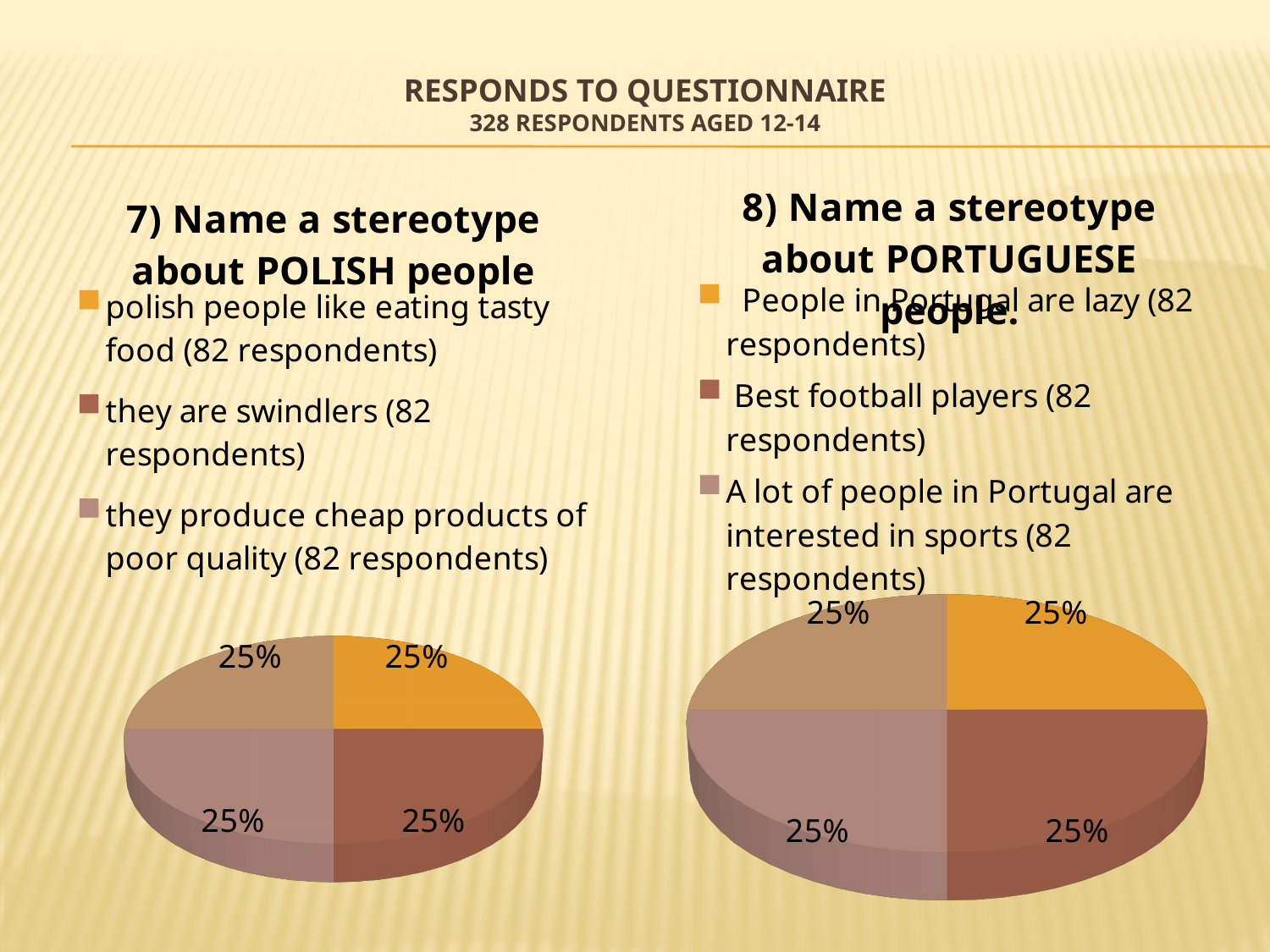
What is the title of the right pie chart? 8) Name a stereotype about PORTUGUESE people. In the right pie chart (PORTUGUESE people), which is larger: the slice for 'People in Portugal are lazy' or the slice for 'A lot of people in Portugal are interested in sports'? they are equal In the left pie chart (POLISH people), what share of the pie does the slice for 'they are swindlers' represent? 25% In the left pie chart (POLISH people), which is larger: the slice for 'they are swindlers' or the slice for 'they produce cheap products of poor quality'? they are equal In the right pie chart (PORTUGUESE people), what share of the pie does the slice for 'Best football players' represent? 25% In the right pie chart (PORTUGUESE people), what share of the pie does the slice for 'People in Portugal are lazy' represent? 25% In the left pie chart (POLISH people), how many slices does the pie have? 4 What kind of chart is shown under the heading '8) Name a stereotype about PORTUGUESE people'? pie chart In the right pie chart (PORTUGUESE people), how many slices does the pie have? 4 What kind of chart is shown under the heading '7) Name a stereotype about POLISH people'? pie chart How many legend entries are listed for the left pie chart (POLISH people)? 3